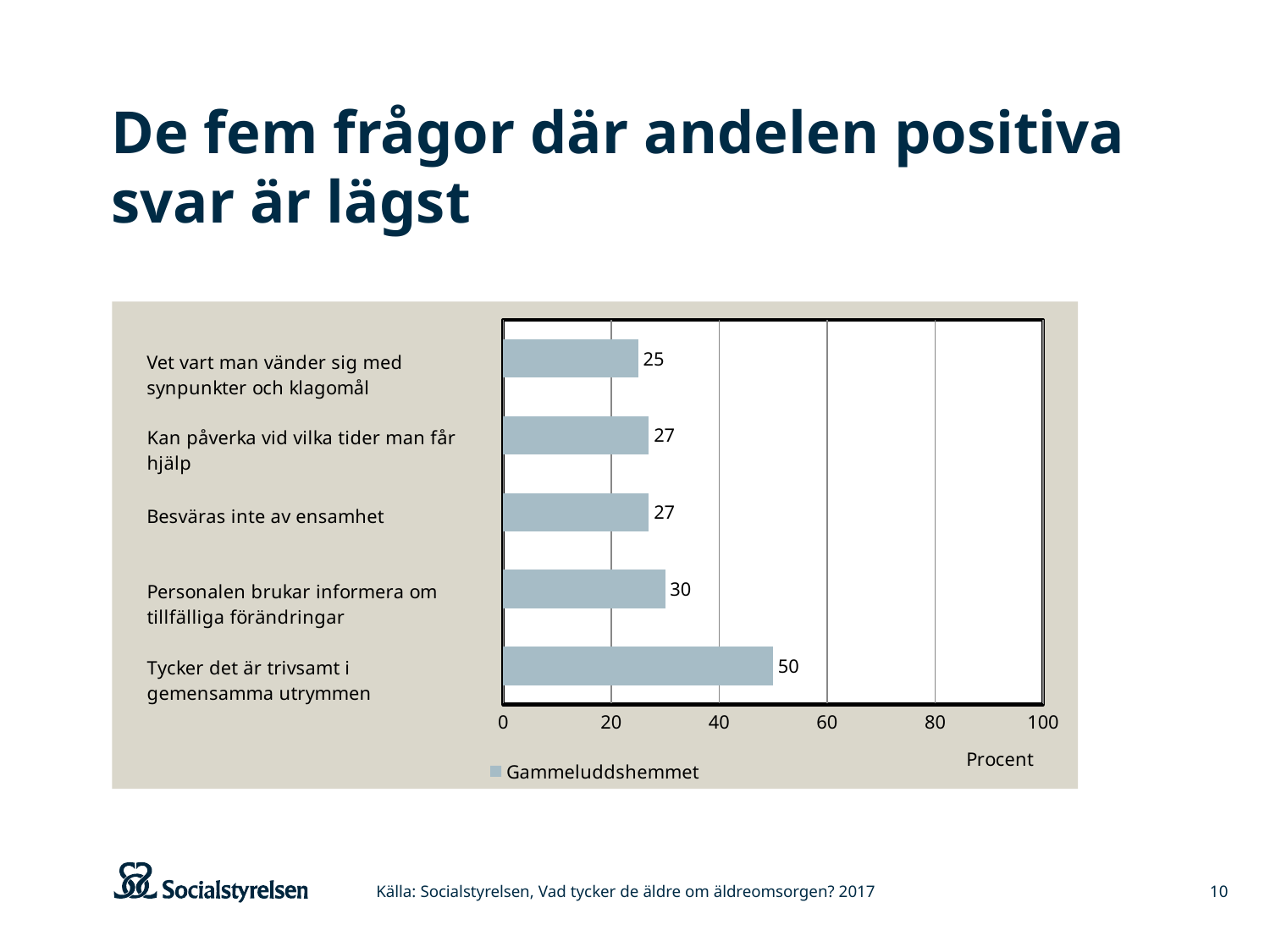
What kind of chart is shown on the slide? Bar chart What is the difference between the values for "Tycker det är trivsamt i gemensamma utrymmen" and "Vet vart man vänder sig med synpunkter och klagomål"? 25 How many series does the legend list? 1 How many categories are shown in the chart? 5 What is the value for "Vet vart man vänder sig med synpunkter och klagomål"? 25 What is the value for "Tycker det är trivsamt i gemensamma utrymmen"? 50 Which category has the lowest value? Vet vart man vänder sig med synpunkter och klagomål Which is larger, the value for "Personalen brukar informera om tillfälliga förändringar" or the value for "Kan påverka vid vilka tider man får hjälp"? Personalen brukar informera om tillfälliga förändringar What is the value for "Personalen brukar informera om tillfälliga förändringar"? 30 What is the value for "Besväras inte av ensamhet"? 27 Is the value for "Tycker det är trivsamt i gemensamma utrymmen" greater or less than 40? greater Which category has the highest value? Tycker det är trivsamt i gemensamma utrymmen